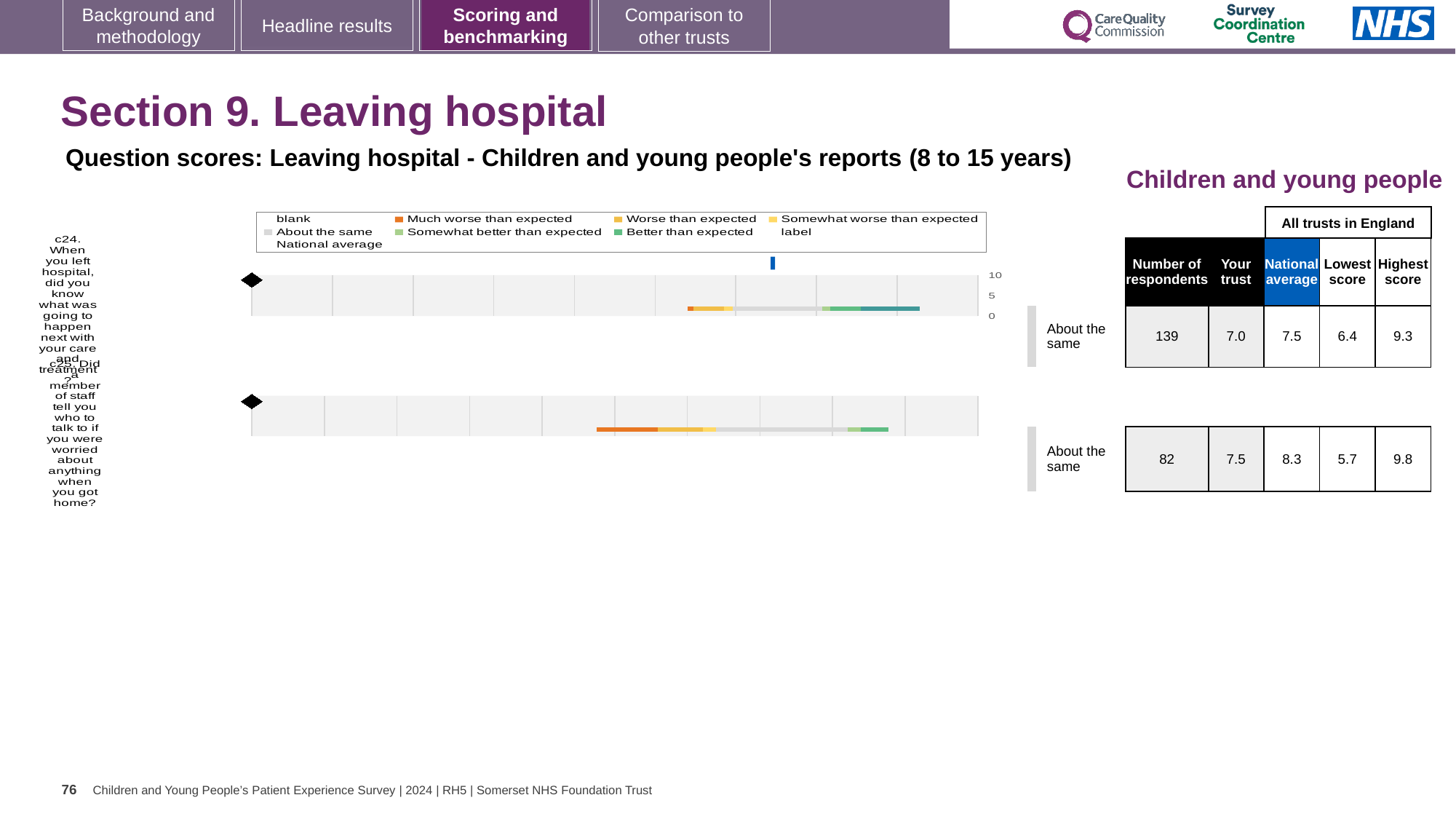
According to the table beside the chart, what is the 'Your trust' score for question c24 (When you left hospital, did you know what was going to happen next with your care and treatment?)? 7.0 What is the difference between the highest score (9.3) and the lowest score (6.4) for question c24 in the table? 2.9 According to the table beside the chart, what is the national average score for question c25 (Did a member of staff tell you who to talk to if you were worried about anything when you got home?)? 8.3 In the chart legend, which colour represents 'Much worse than expected'? orange In the chart legend, which colour represents 'Better than expected'? green How many questions (c24 and c25) are plotted in the benchmarking charts on this slide? 2 According to the table beside the chart, what is the highest score among all trusts in England for question c25? 9.8 What benchmark category is shown next to the chart for question c24? About the same What is the difference between the national average (8.3) and the 'Your trust' score (7.5) for question c25 in the table? 0.8 Which question has the higher national average score in the table, c24 or c25? c25 According to the table beside the chart, how many respondents answered question c24? 139 What kind of chart is used to show the question scores on this slide? bar chart